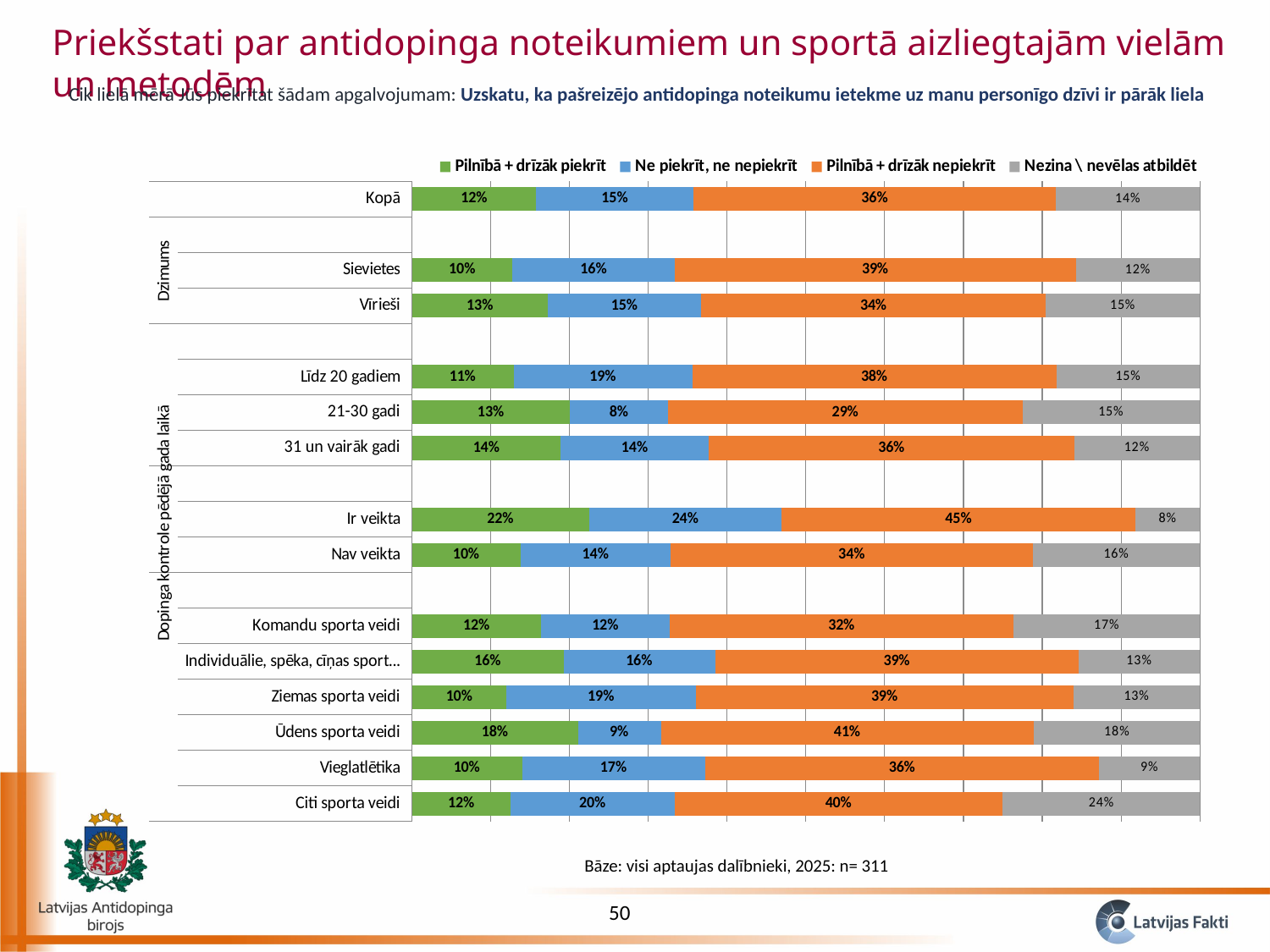
What is the 'Nezina \ nevēlas atbildēt' value for Citi sporta veidi? 24% Which has a larger 'Pilnībā + drīzāk piekrīt' value, Ir veikta or Nav veikta? Ir veikta What percentage of Kopā respondents chose 'Pilnībā + drīzāk nepiekrīt'? 36% What is the 'Ne piekrīt, ne nepiekrīt' value for 21-30 gadi? 8% Which category has the highest 'Pilnībā + drīzāk nepiekrīt' value? Ir veikta Which category has the highest 'Nezina \ nevēlas atbildēt' value? Citi sporta veidi How many categories are plotted in the chart? 14 What is the 'Pilnībā + drīzāk piekrīt' value for Ir veikta? 22% Which category has the lowest 'Nezina \ nevēlas atbildēt' value? Ir veikta What is the difference in 'Pilnībā + drīzāk nepiekrīt' between Sievietes and Vīrieši? 5 percentage points What kind of chart is shown on the slide? Stacked bar chart How many series does the legend list? 4